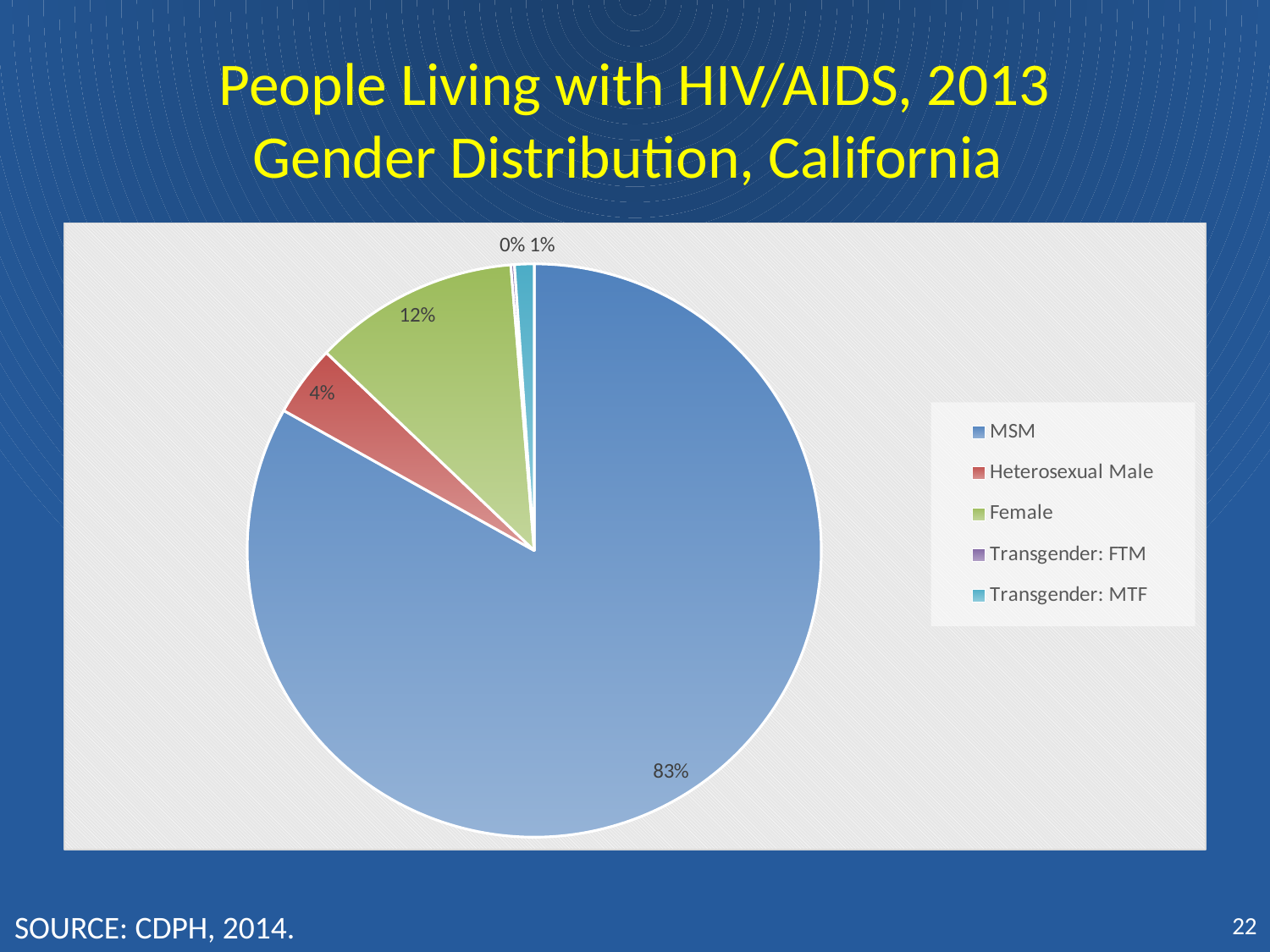
Which category has the smallest slice of the pie? Transgender: FTM How many categories does the legend list? 5 What share of the pie does MSM account for? 83% What percentage is shown for Female? 12% Which category has the largest slice of the pie? MSM What percentage is shown for Transgender: FTM? 0% What percentage is shown for Heterosexual Male? 4% What kind of chart is shown on the slide? Pie chart What is the source cited at the bottom of the slide? CDPH, 2014 What is the difference in percentage points between Female and Heterosexual Male? 8 Which is larger, the share for Female or the share for Heterosexual Male? Female What percentage is shown for Transgender: MTF? 1%